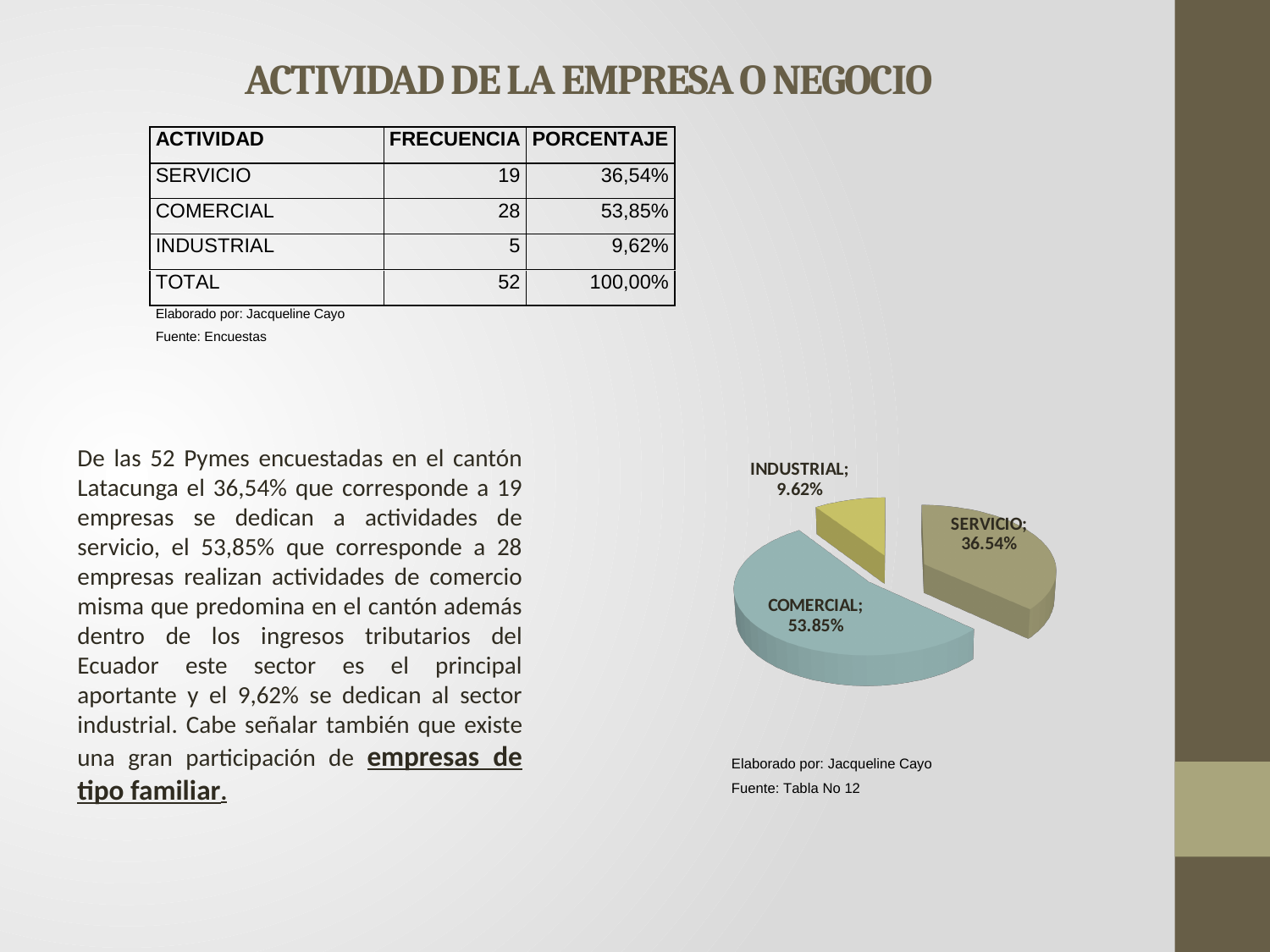
What percentage does the pie chart show for SERVICIO? 36.54% What percentage does the pie chart show for COMERCIAL? 53.85% What is the difference in percentage points between the COMERCIAL and SERVICIO slices in the pie chart? 17.31 How many slices does the pie chart have? 3 What is the difference in percentage points between the SERVICIO and INDUSTRIAL slices in the pie chart? 26.92 Which category has the largest slice in the pie chart? COMERCIAL In the pie chart, which is larger, SERVICIO or INDUSTRIAL? SERVICIO Is the COMERCIAL slice of the pie chart more or less than half of the pie? more Which category has the smallest slice in the pie chart? INDUSTRIAL What kind of chart is shown on the slide? Pie chart What is the title shown above the table and chart on the slide? ACTIVIDAD DE LA EMPRESA O NEGOCIO What percentage does the pie chart show for INDUSTRIAL? 9.62%